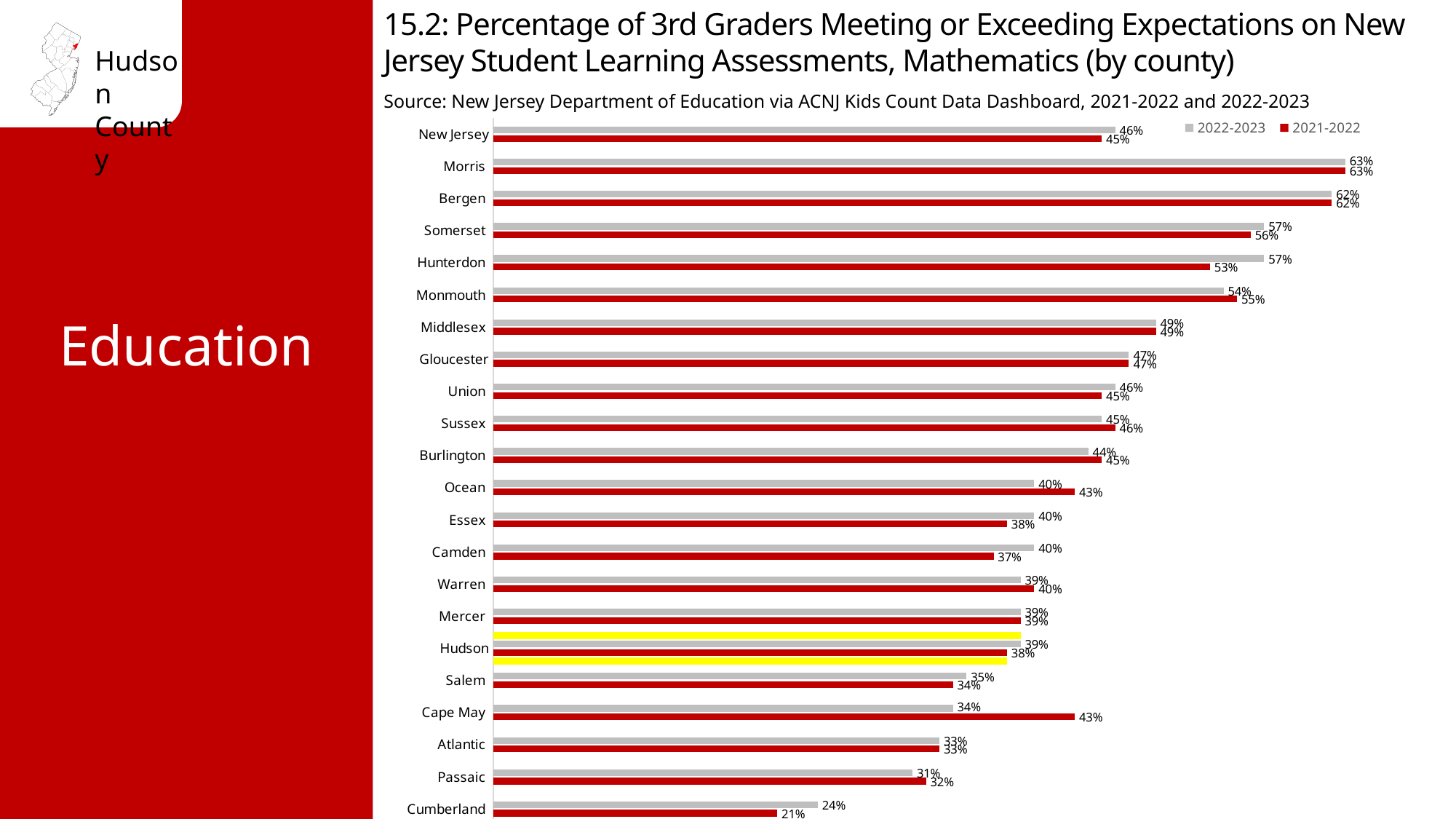
What kind of chart is shown on the slide? Bar chart Which county's bars are highlighted in yellow? Hudson Which county has the lowest 2021-2022 value? Cumberland What is the difference between the 2021-2022 and 2022-2023 values for Cape May? 9% What is the 2022-2023 value for Hunterdon? 57% What is the 2022-2023 value for Hudson? 39% How many counties or regions are listed on the chart? 22 What is the 2021-2022 value for Cape May? 43% How many series does the legend list? 2 What is the difference between the 2022-2023 values for Hunterdon and Hudson? 18% Which is larger for Ocean: the 2022-2023 value or the 2021-2022 value? 2021-2022 Which county has the highest 2022-2023 value? Morris